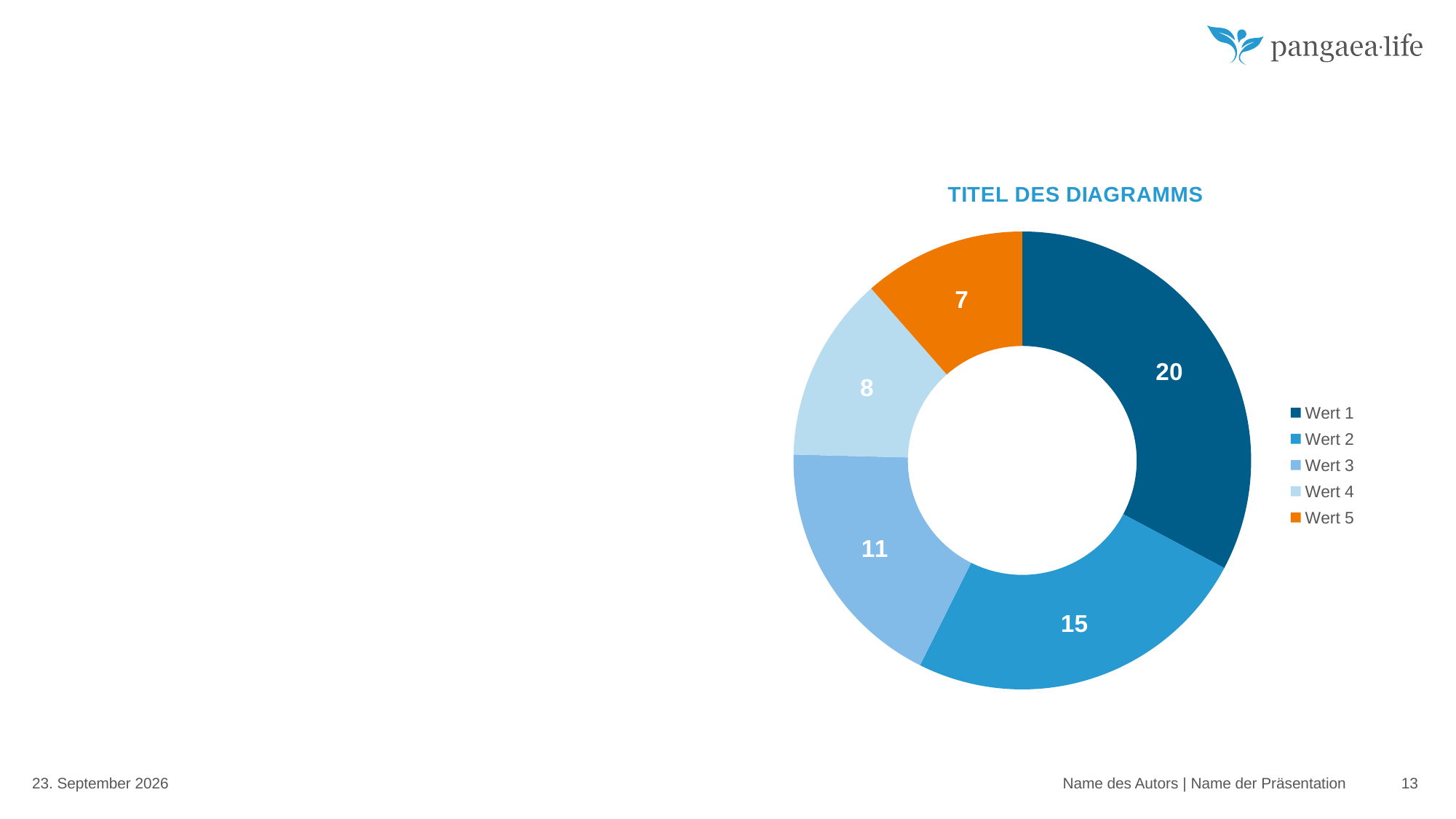
How many categories are shown in the chart? 5 Which is larger, the value for Wert 3 or the value for Wert 4? Wert 3 What is the total of all values in the chart? 61 Which category is shown in orange? Wert 5 What is the value for Wert 1? 20 What is the title of the chart? TITEL DES DIAGRAMMS Which category has the largest value? Wert 1 What is the difference between the values for Wert 1 and Wert 2? 5 Which category has the smallest value? Wert 5 What is the value for Wert 3? 11 What is the value for Wert 5? 7 What kind of chart is shown on the slide? Doughnut chart